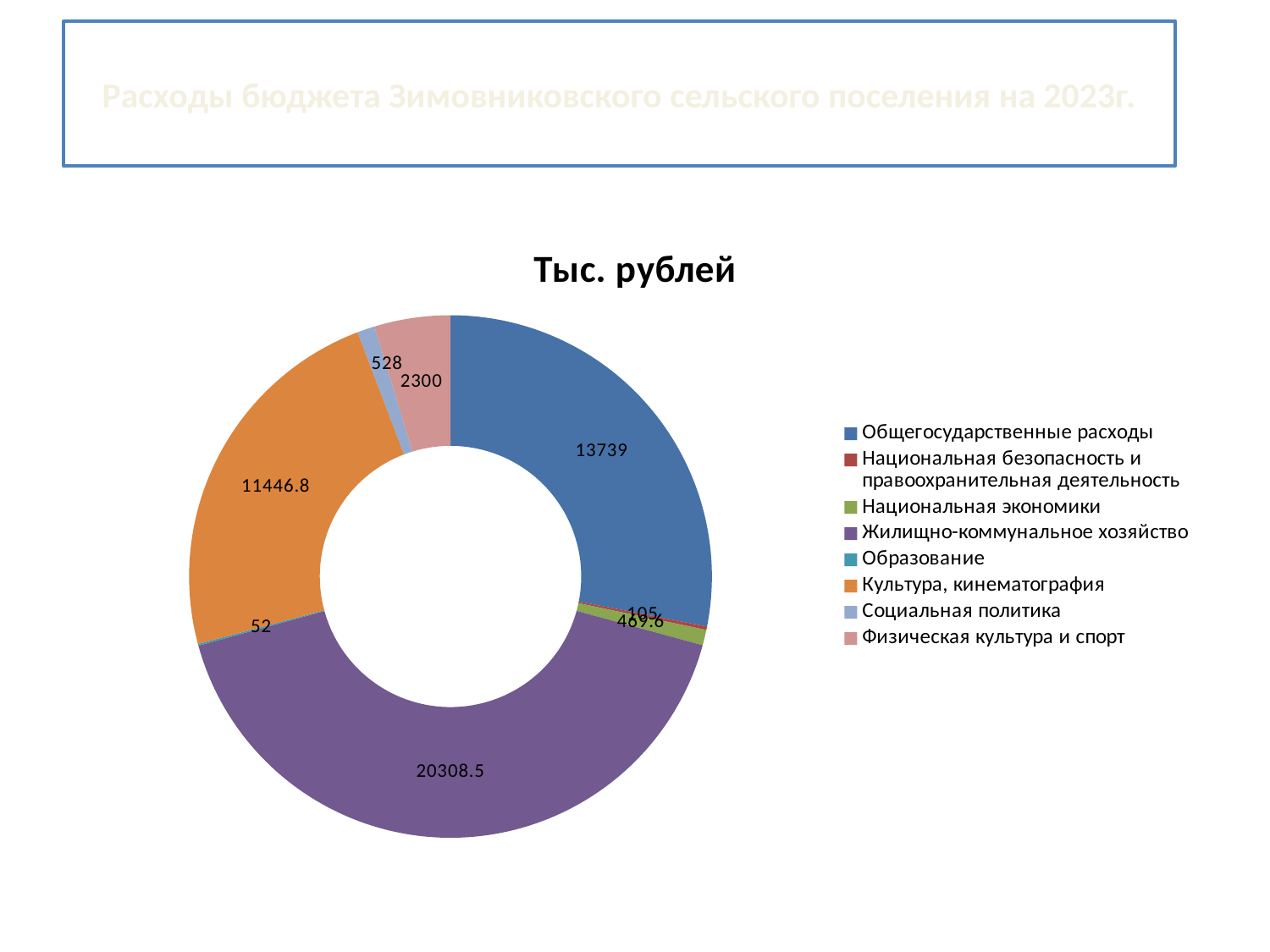
Which category has the smallest value? Образование What is the difference between the values for Жилищно-коммунальное хозяйство and Общегосударственные расходы? 6569.5 What kind of chart is shown on the slide? Doughnut (pie) chart What is the value for Социальная политика? 528 What is the value for Физическая культура и спорт? 2300 What is the value for Общегосударственные расходы? 13739 What is the value for Жилищно-коммунальное хозяйство? 20308.5 What is the value for Культура, кинематография? 11446.8 What is the title of the chart? Тыс. рублей How many categories does the legend list? 8 Which category has the largest value? Жилищно-коммунальное хозяйство Which is larger, the value for Культура, кинематография or the value for Физическая культура и спорт? Культура, кинематография